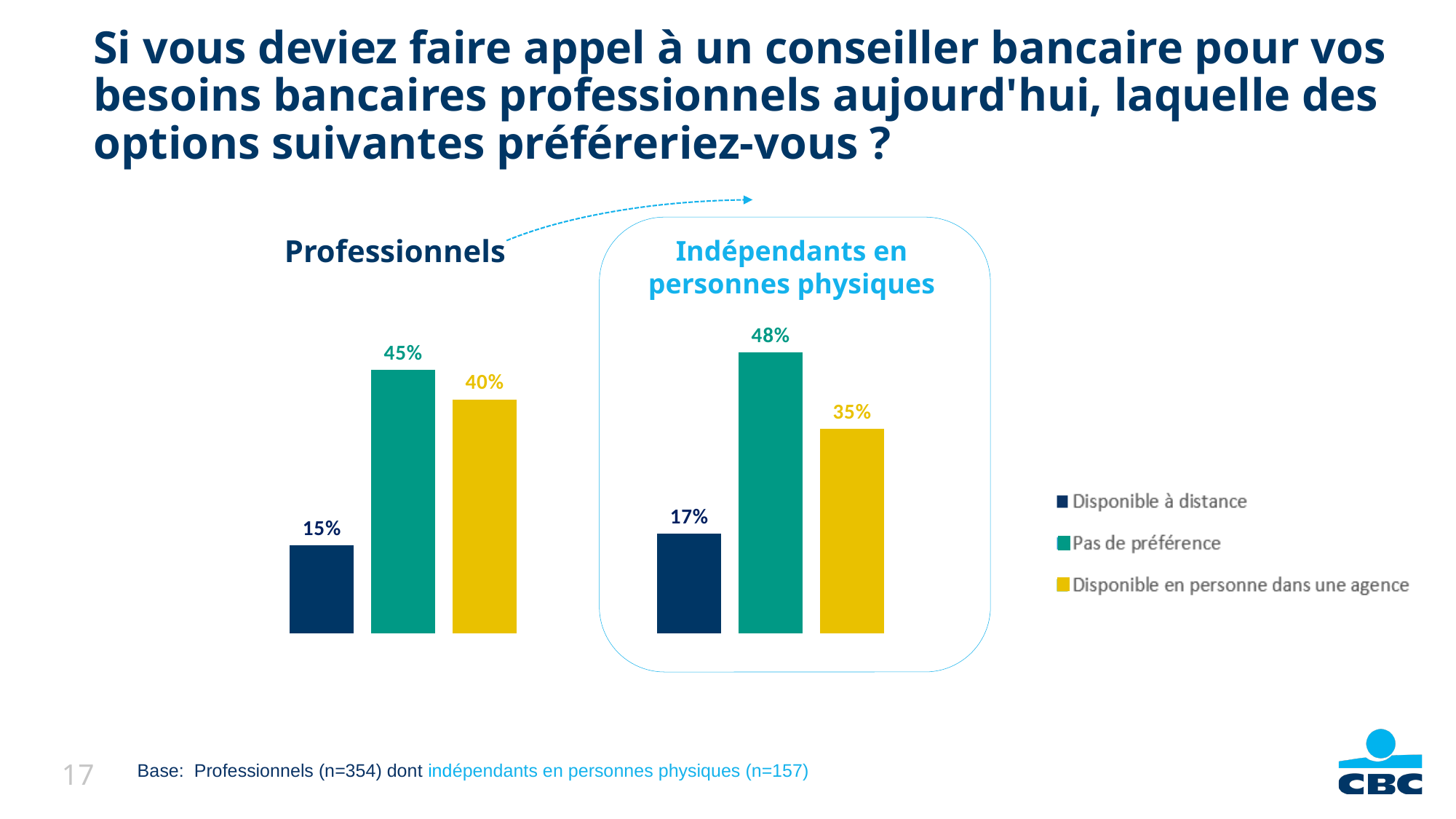
Which option has the highest value in the Indépendants en personnes physiques group? Pas de préférence Which is larger: "Disponible en personne dans une agence" for Professionnels or for Indépendants en personnes physiques? Professionnels What is the difference between "Disponible à distance" for Indépendants en personnes physiques and for Professionnels? 2% Which colour represents "Pas de préférence" in the legend? Teal (green) Which option has the lowest value in the Professionnels group? Disponible à distance What is the value for "Pas de préférence" in the Professionnels group? 45% How many series does the legend list? 3 What is the value for "Disponible à distance" in the Indépendants en personnes physiques group? 17% What is the value for "Disponible en personne dans une agence" in the Professionnels group? 40% What is the value for "Disponible en personne dans une agence" in the Indépendants en personnes physiques group? 35% What kind of chart is shown on the slide? Bar chart What is the difference between "Pas de préférence" and "Disponible en personne dans une agence" in the Indépendants en personnes physiques group? 13%